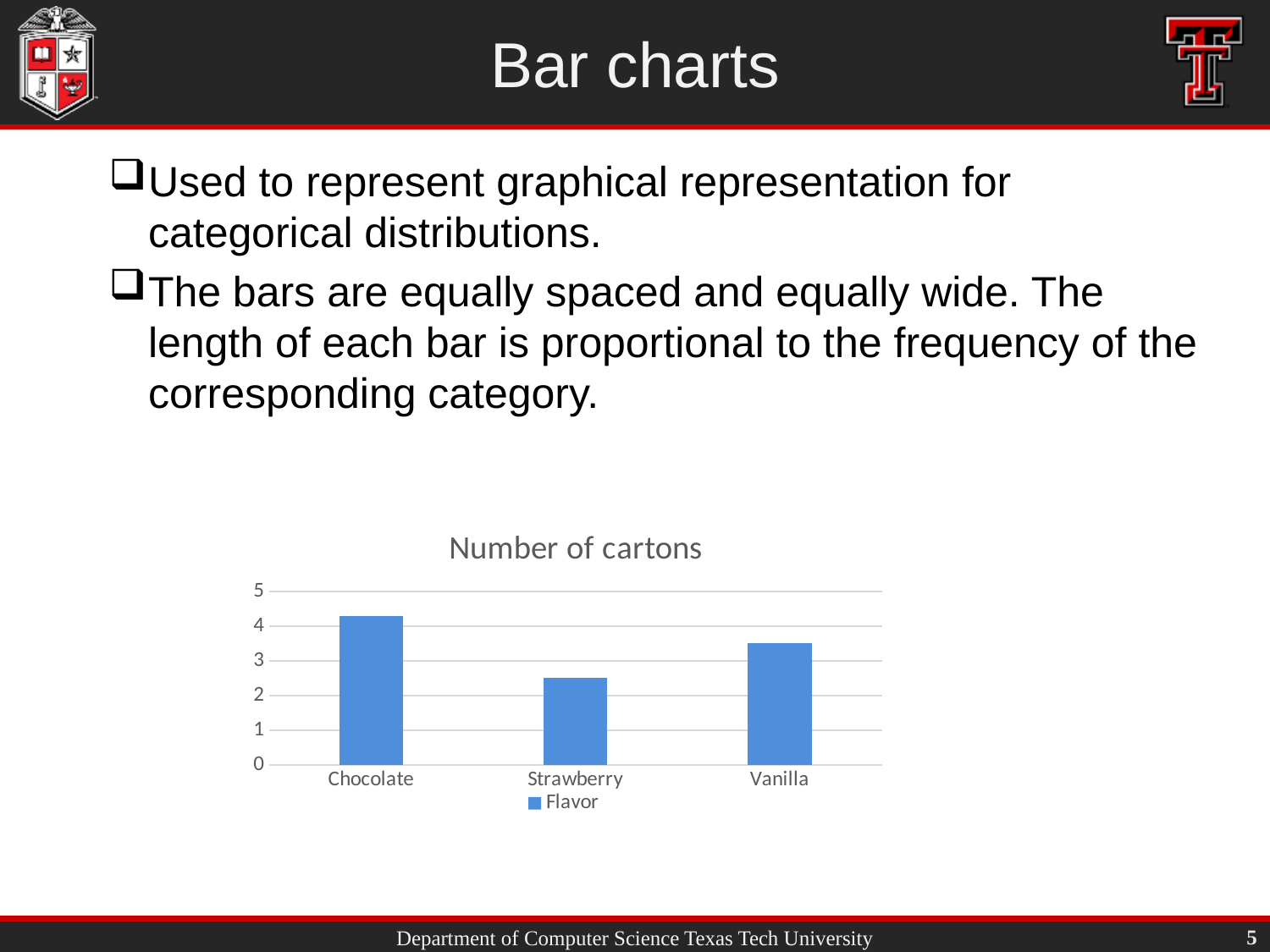
Is the value for Chocolate greater or less than 4? greater What is the title of the chart? Number of cartons Which has more cartons, Chocolate or Vanilla? Chocolate Which has more cartons, Strawberry or Vanilla? Vanilla What type of chart is shown on the slide? bar chart How many series does the chart's legend list? 1 Is the value for Strawberry greater or less than 3? less How many categories are shown on the x axis of the chart? 3 Which flavor has the lowest number of cartons? Strawberry What series name is shown in the chart's legend? Flavor Which flavor has the highest number of cartons? Chocolate Is the value for Vanilla greater or less than 3? greater